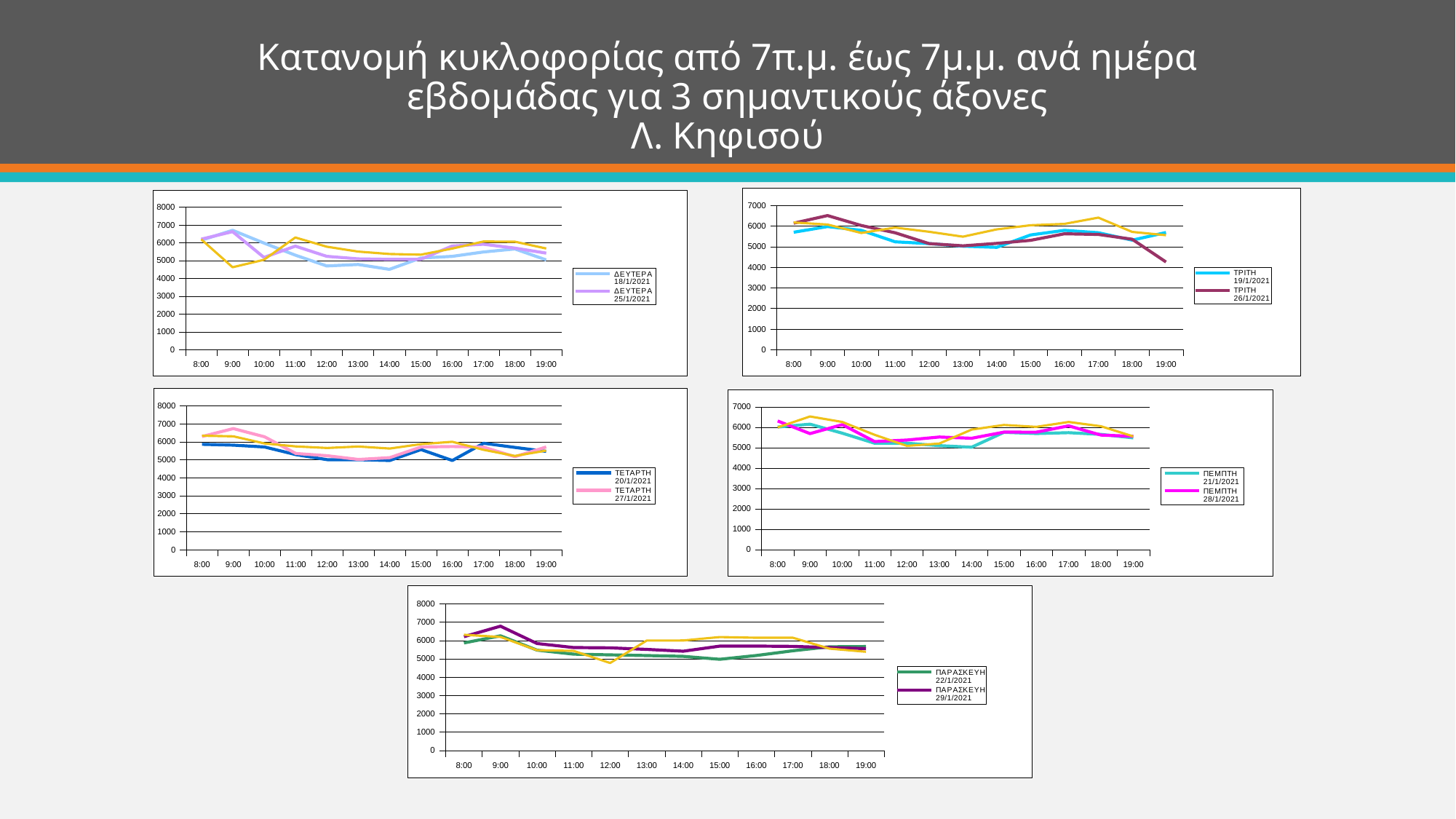
In the top-right chart, is the value for ΤΡΙΤΗ 26/1/2021 at 19:00 greater or less than 5000? less How many charts are shown on the slide? 5 Which two dates are listed in the legend of the bottom chart (ΠΑΡΑΣΚΕΥΗ)? 22/1/2021 and 29/1/2021 In the top-left chart, is the value for ΔΕΥΤΕΡΑ 18/1/2021 at 14:00 greater or less than 5000? less In the middle-right chart, is the value for ΠΕΜΠΤΗ 28/1/2021 at 8:00 greater or less than 6000? greater What kind of chart is the top-left chart (ΔΕΥΤΕΡΑ)? line chart How many series does the legend of the top-right chart (ΤΡΙΤΗ) list? 2 How many time points are shown on the x axis of the bottom chart (ΠΑΡΑΣΚΕΥΗ)? 12 In the top-right chart, does the ΤΡΙΤΗ 26/1/2021 line rise or fall from 17:00 to 19:00? fall